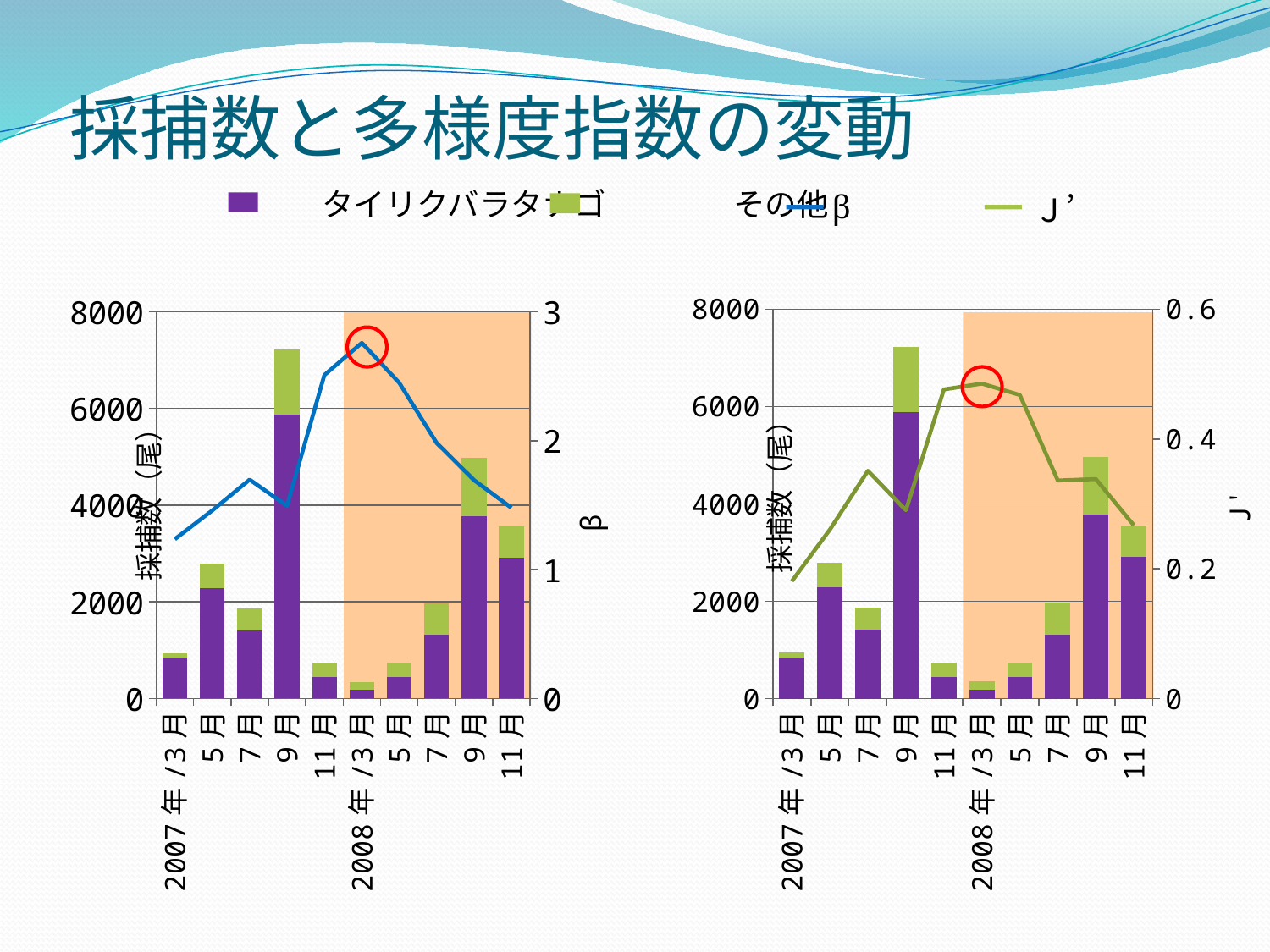
In the left chart, is the β value at 2008年3月 greater or less than 2? greater In the right chart, is the J' value at 2008年3月 greater or less than 0.4? greater Which colour represents タイリクバラタナゴ in the stacked bars? Purple What kind of chart is the left chart? Combination of a stacked bar chart and a line chart What is the label on the right-hand vertical axis of the right chart? J' In the left chart, does the β line rise or fall from 2008年3月 to 2008年11月? fall How many time-period categories are shown on the x axis of the left chart? 10 How many series does the legend at the top of the slide list? 4 In the left chart, which stacked bar is taller, 2007年5月 or 2007年7月? 2007年5月 In the left chart, which period has the tallest stacked bar? 2007年9月 In the left chart, is the total bar height for 2007年9月 greater or less than 6000? greater In the right chart, which period has the shortest stacked bar? 2008年3月